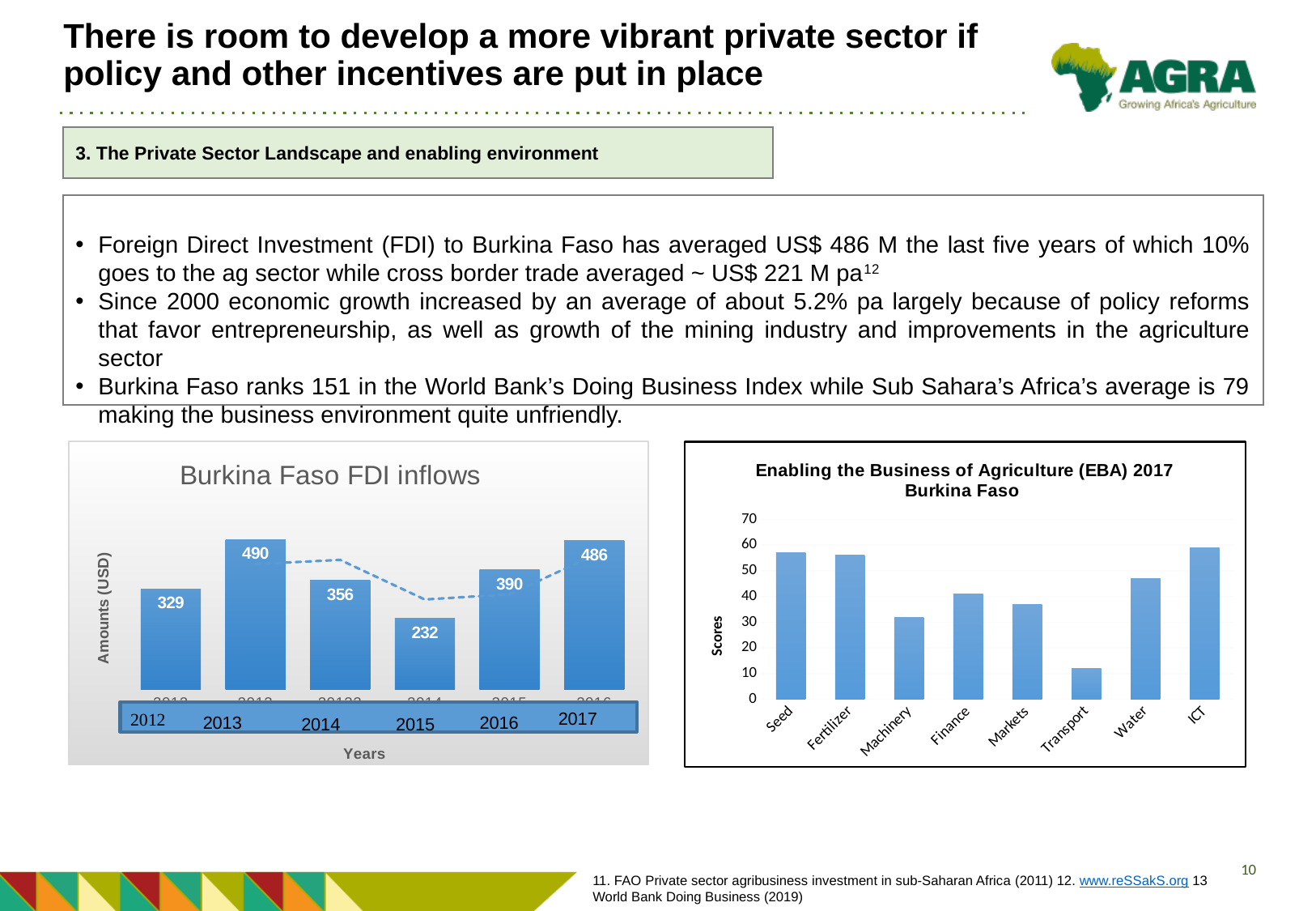
How many years are shown in the Burkina Faso FDI inflows chart? 6 In the Enabling the Business of Agriculture (EBA) 2017 Burkina Faso chart, is the score for Water greater or less than 40? greater In the Enabling the Business of Agriculture (EBA) 2017 Burkina Faso chart, which category has the lowest score? Transport What type of chart is the Burkina Faso FDI inflows chart? Bar chart In the Enabling the Business of Agriculture (EBA) 2017 Burkina Faso chart, is the score for Machinery greater or less than 40? less In the Burkina Faso FDI inflows chart, what is the value for 2015? 232 How many categories are shown in the Enabling the Business of Agriculture (EBA) 2017 Burkina Faso chart? 8 In the Burkina Faso FDI inflows chart, which year has the lowest FDI inflow? 2015 In the Burkina Faso FDI inflows chart, which is larger, the value for 2014 or the value for 2016? 2016 In the Burkina Faso FDI inflows chart, what is the difference between the 2017 value and the 2012 value? 157 In the Burkina Faso FDI inflows chart, what is the value for 2013? 490 In the Burkina Faso FDI inflows chart, which year has the highest FDI inflow? 2013